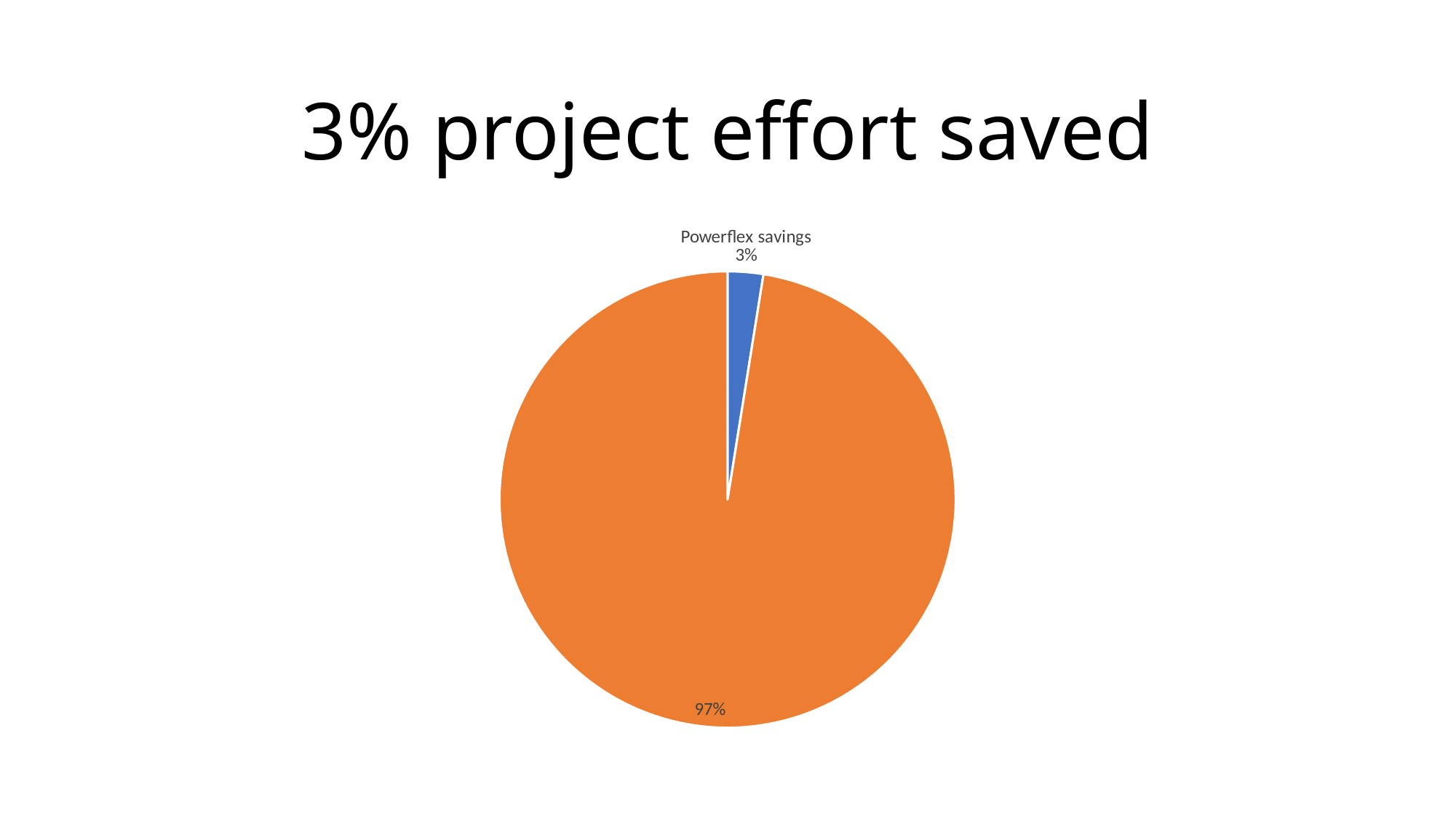
What kind of chart is shown on the slide? pie chart What is the difference between the 97% slice and the Powerflex savings slice? 94% Which slice is the smallest in the pie chart? Powerflex savings Is the share of the Powerflex savings slice greater or less than 10%? less What colour is the Powerflex savings slice? blue What is the title of the slide? 3% project effort saved What share of the pie does the Powerflex savings slice represent? 3% Which slice is larger, the Powerflex savings slice or the orange slice? the orange slice What percentage is shown on the large orange slice? 97% How many slices does the pie chart have? 2